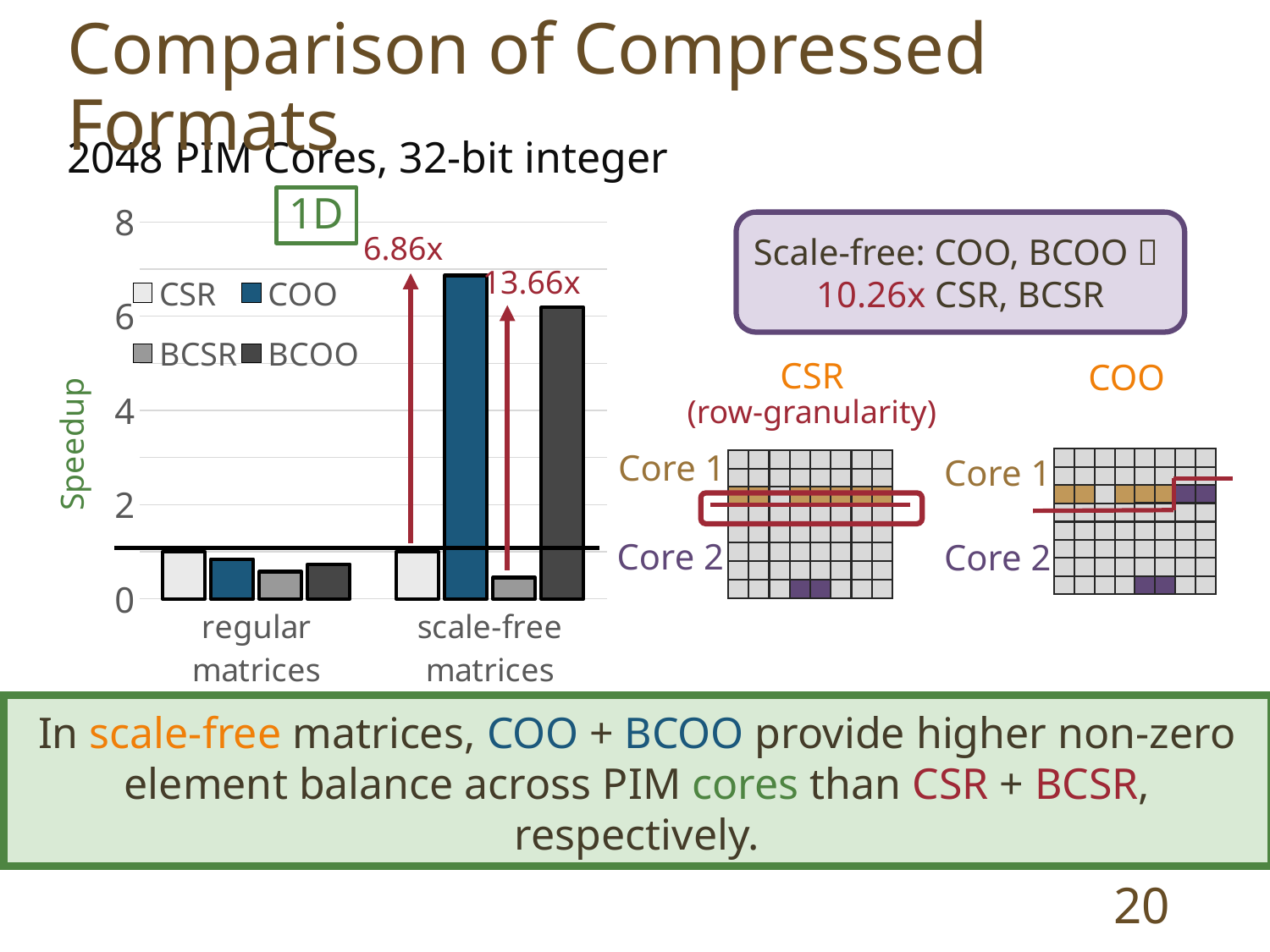
Is the speedup for BCOO on scale-free matrices greater or less than 4? greater What annotation is written above the COO bar for scale-free matrices? 6.86x How many series does the chart legend list? 4 What is the label on the y axis of the chart? Speedup How many categories are shown on the x axis of the chart? 2 Is the speedup for COO on scale-free matrices greater or less than 6? greater Which series has the highest speedup for scale-free matrices? COO What kind of chart is shown on the slide? bar chart For scale-free matrices, which has the larger speedup, COO or BCOO? COO For scale-free matrices, which has the larger speedup, CSR or BCSR? CSR Which series has the lowest speedup for scale-free matrices? BCSR Is the speedup for BCSR on regular matrices greater or less than 1? less